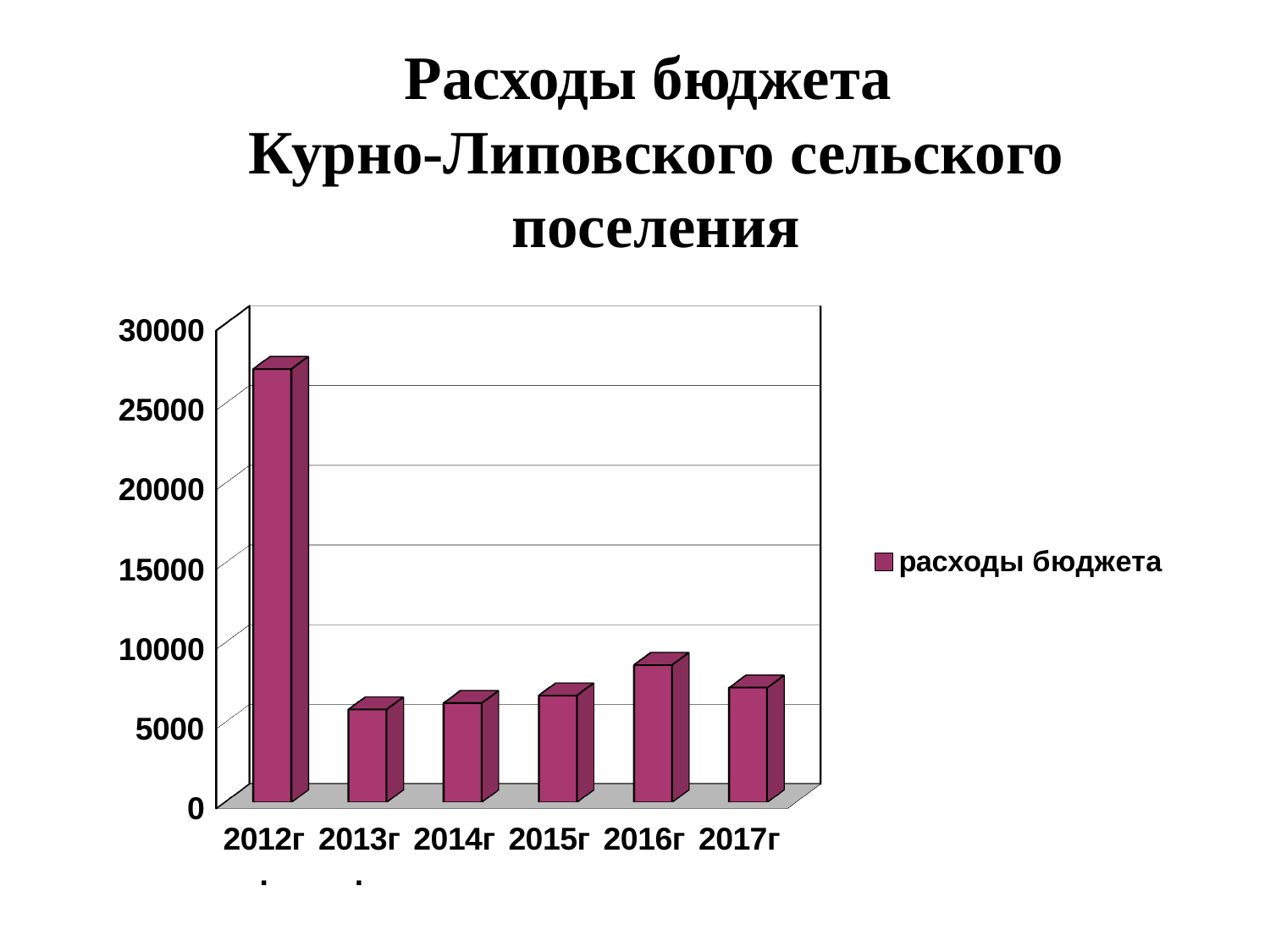
Is the value for 2016г greater or less than 10000? less Is the value for 2017г greater or less than 5000? greater Which is larger, the value for 2016г or the value for 2013г? 2016г What is the name of the series shown in the chart legend? расходы бюджета Which is larger, the value for 2012г or the value for 2017г? 2012г How many series does the chart legend list? 1 Is the value for 2012г greater or less than 25000? greater What kind of chart is shown on the slide? bar chart How many years are shown on the x axis of the chart? 6 Do the values rise or fall from 2013г to 2016г? rise Which year has the highest budget expenditure in the chart? 2012г